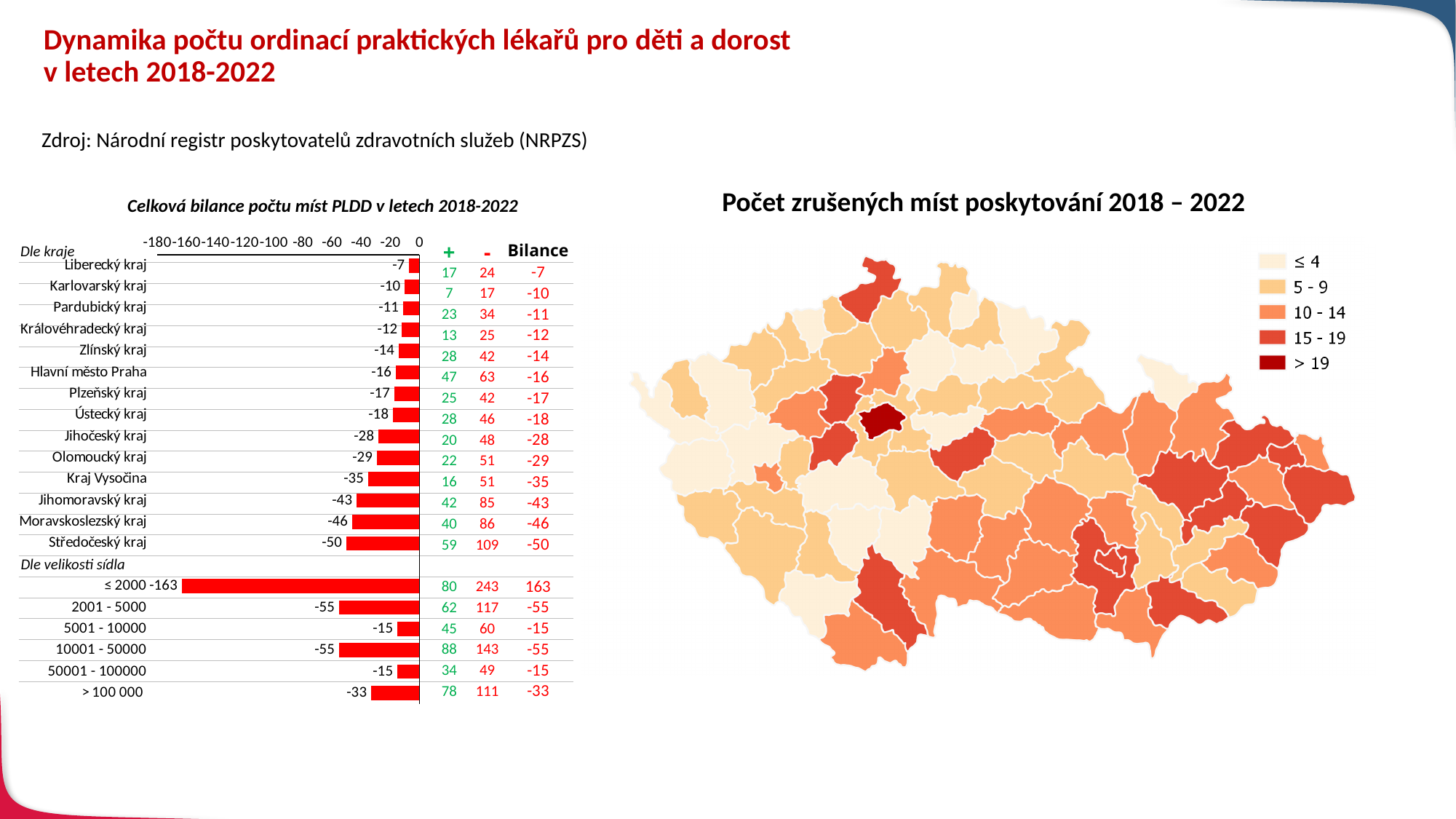
What type of chart is 'Celková bilance počtu míst PLDD v letech 2018-2022'? Bar chart In the bar chart 'Celková bilance počtu míst PLDD v letech 2018-2022', what is the difference between the values for Moravskoslezský kraj and Jihomoravský kraj? 3 In the bar chart 'Celková bilance počtu míst PLDD v letech 2018-2022', what is the value for Kraj Vysočina? -35 In the bar chart 'Celková bilance počtu míst PLDD v letech 2018-2022', what is the value for the size category ≤ 2000? -163 How many categories does the legend of the map 'Počet zrušených míst poskytování 2018 – 2022' list? 5 In the bar chart 'Celková bilance počtu míst PLDD v letech 2018-2022', what is the value for Hlavní město Praha? -16 In the bar chart 'Celková bilance počtu míst PLDD v letech 2018-2022', which region (Dle kraje) has the value closest to zero? Liberecký kraj In the bar chart 'Celková bilance počtu míst PLDD v letech 2018-2022', what is the value for Středočeský kraj? -50 In the bar chart 'Celková bilance počtu míst PLDD v letech 2018-2022', which has the more negative value: Jihočeský kraj or Olomoucký kraj? Olomoucký kraj In the bar chart 'Celková bilance počtu míst PLDD v letech 2018-2022', which region (Dle kraje) has the most negative value? Středočeský kraj In the bar chart 'Celková bilance počtu míst PLDD v letech 2018-2022', which category has the lowest (most negative) value? ≤ 2000 How many regions (Dle kraje) are shown in the bar chart 'Celková bilance počtu míst PLDD v letech 2018-2022'? 14